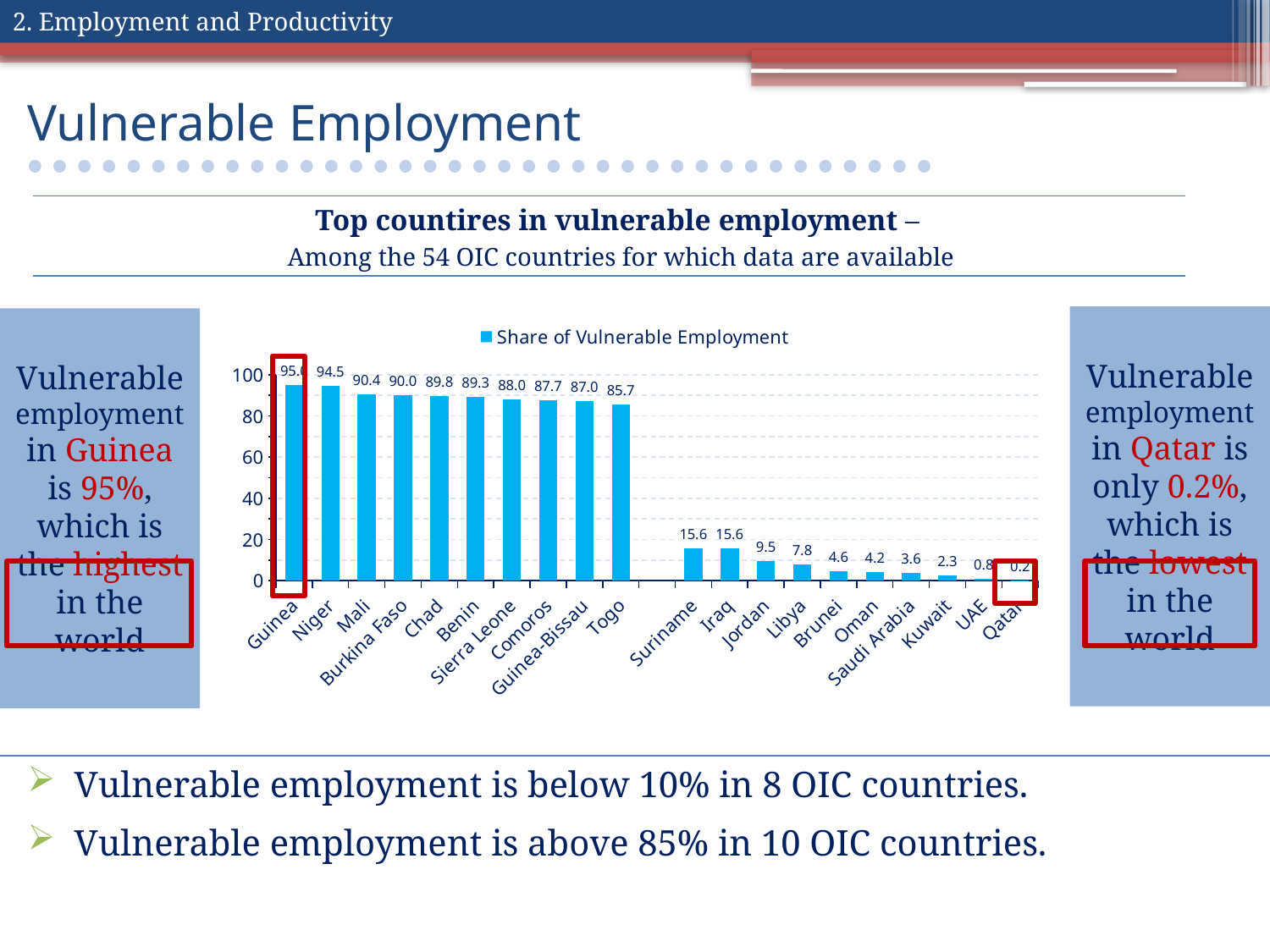
What is the share of vulnerable employment for Niger? 94.5 Which country has the highest share of vulnerable employment? Guinea Which country has the lowest share of vulnerable employment? Qatar What is the share of vulnerable employment for Togo? 85.7 Which has a larger share of vulnerable employment, Mali or Togo? Mali What is the legend entry of the series plotted in the chart? Share of Vulnerable Employment What is the difference between the values for Suriname and Jordan? 6.1 What is the difference between the values for Niger and Mali? 4.1 What is the share of vulnerable employment for Jordan? 9.5 What type of chart is shown on the slide? Bar chart What is the share of vulnerable employment for Qatar? 0.2 How many countries are shown in the chart? 20